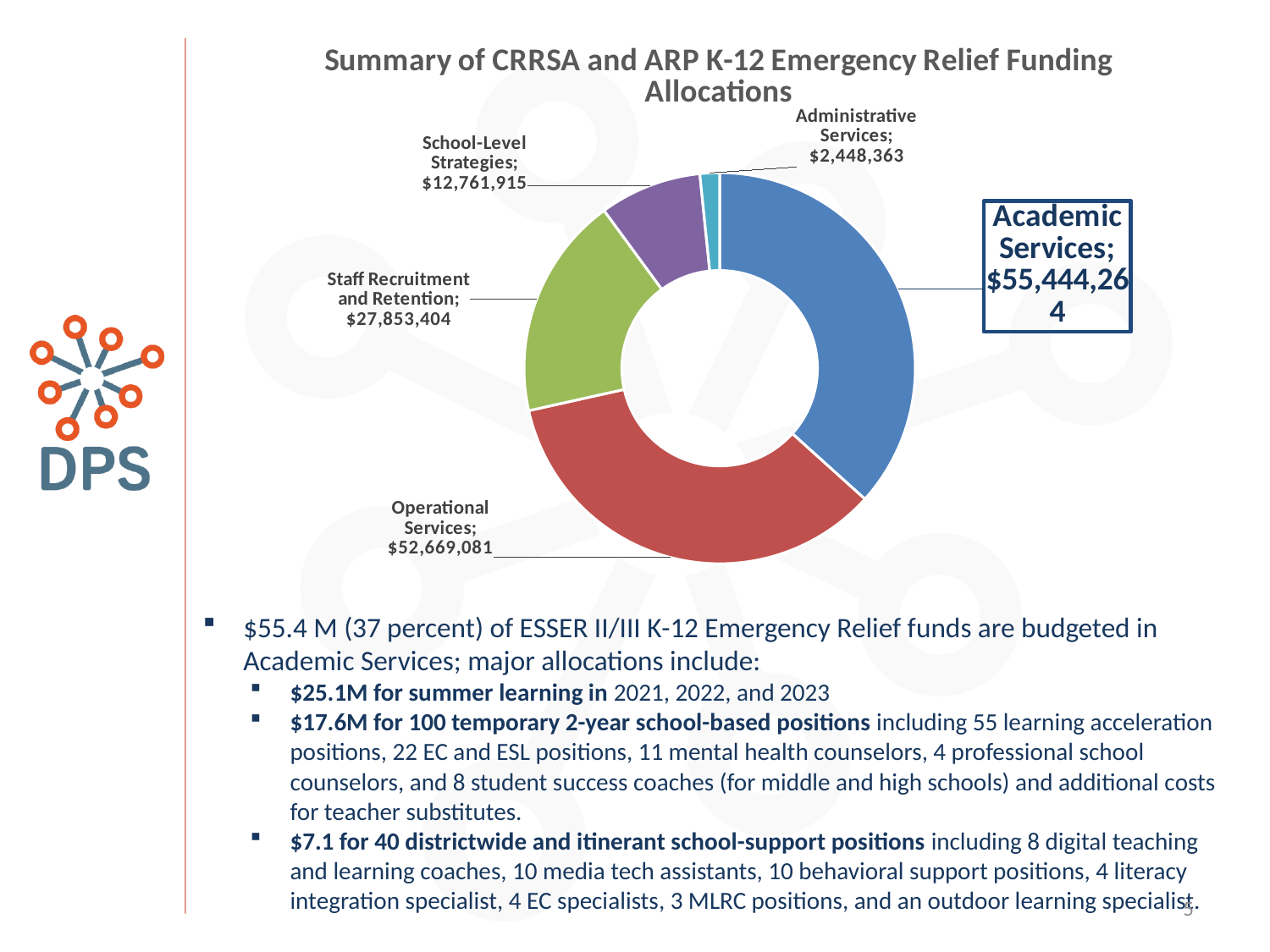
What kind of chart is shown on the slide? Doughnut (pie) chart Which is larger, the allocation for Staff Recruitment and Retention or for School-Level Strategies? Staff Recruitment and Retention What is the difference between the Staff Recruitment and Retention allocation and the School-Level Strategies allocation? $15,091,489 What is the allocation for Academic Services? $55,444,264 Which category has the smallest allocation? Administrative Services What is the allocation for Administrative Services? $2,448,363 What is the allocation for Staff Recruitment and Retention? $27,853,404 What is the allocation for Operational Services? $52,669,081 How many categories are shown in the chart? 5 How much larger is the Academic Services allocation than the Operational Services allocation? $2,775,183 What is the allocation for School-Level Strategies? $12,761,915 Which category has the largest allocation? Academic Services